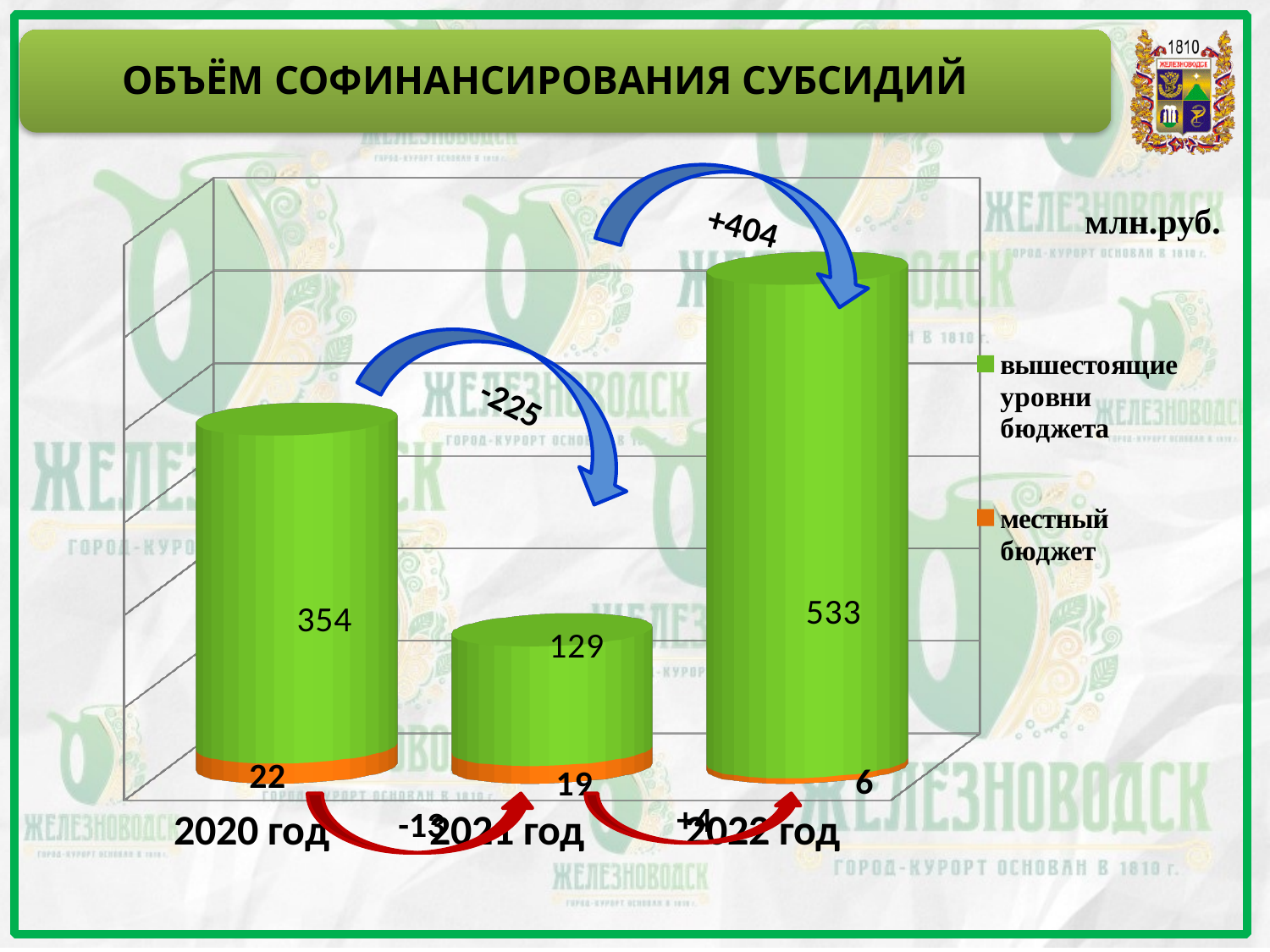
Which is larger: the местный бюджет value for 2020 год or for 2021 год? 2020 год How many years are shown on the x axis? 3 What is the value for вышестоящие уровни бюджета in 2020 год? 354 What is the total of the stacked bar for 2020 год? 376 What is the value for местный бюджет in 2022 год? 6 How many series does the legend list? 2 What is the value for вышестоящие уровни бюджета in 2022 год? 533 What is the difference between the вышестоящие уровни бюджета values for 2022 год and 2021 год? 404 What unit is indicated for the values on the chart? млн.руб. What is the value for местный бюджет in 2021 год? 19 Which year has the lowest value for местный бюджет? 2022 год Which year has the highest value for вышестоящие уровни бюджета? 2022 год